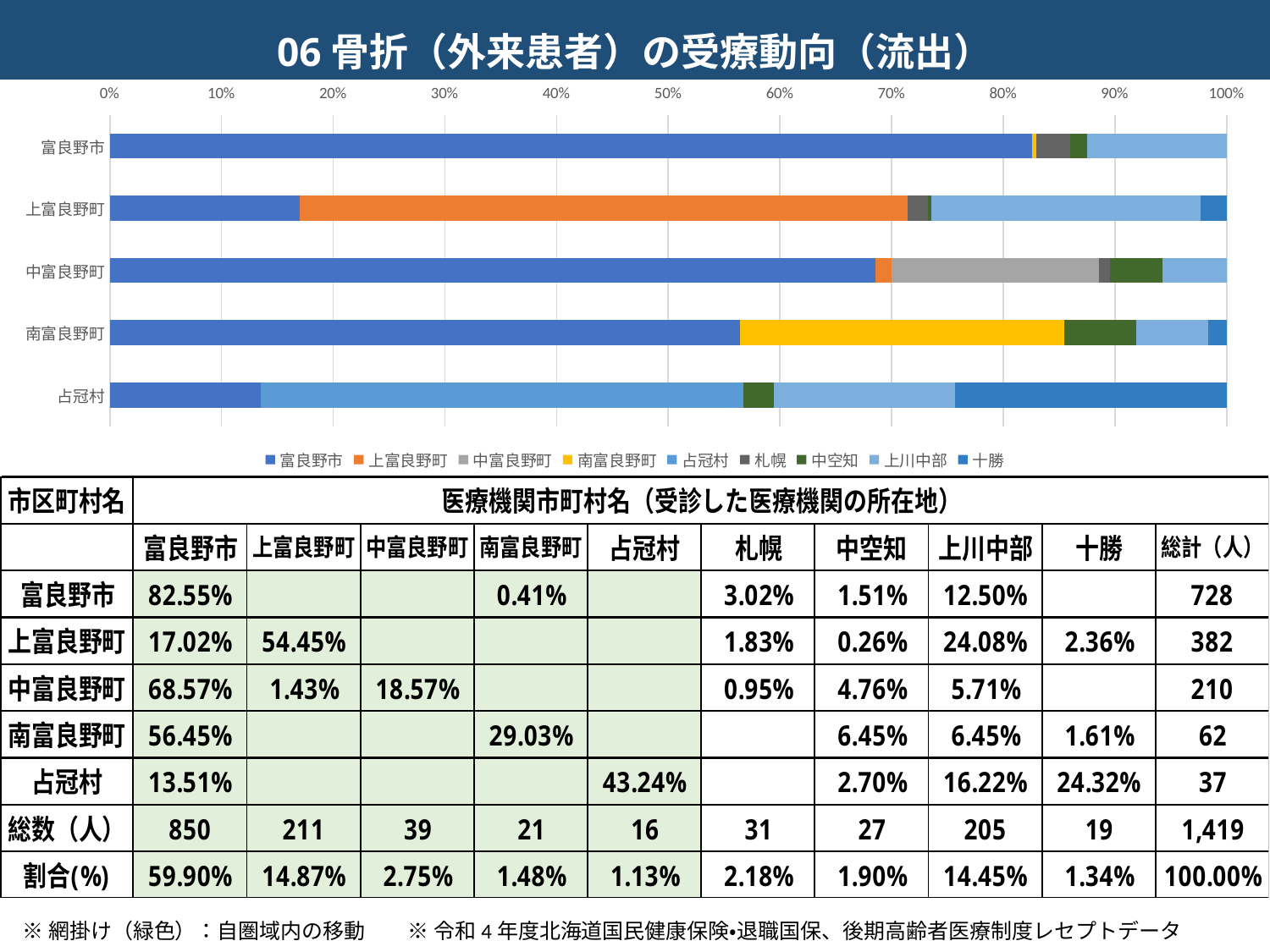
Which municipality has the largest 富良野市 segment in its bar? 富良野市 What share of 占冠村 patients received treatment in 十勝? 24.32% How many municipalities (categories) are plotted on the y axis of the chart? 5 What is the difference between the 富良野市 segment for 富良野市 and the 富良野市 segment for 上富良野町? 65.53% What share of 上富良野町 patients received treatment in 上富良野町? 54.45% What share of 富良野市 patients received treatment in 富良野市? 82.55% What kind of chart is shown on the slide? bar chart How many series does the chart legend list? 9 Which has a larger 富良野市 segment, 中富良野町 or 南富良野町? 中富良野町 Is the 富良野市 segment for 上富良野町 greater or less than 20%? less Is the 富良野市 segment for 南富良野町 greater or less than 50%? greater Which municipality has the smallest 富良野市 segment in its bar? 占冠村